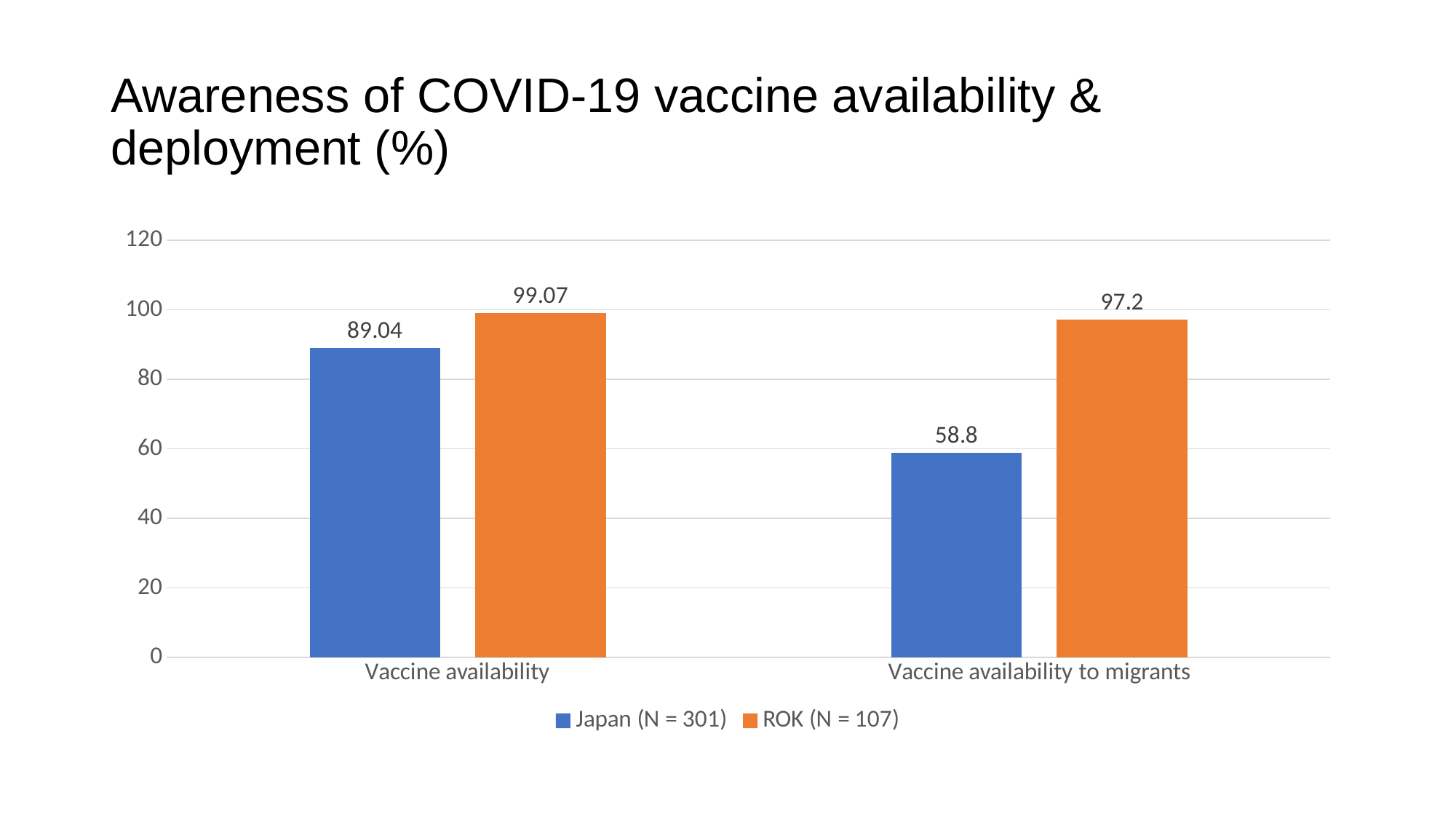
What is the value for Japan (N = 301) for Vaccine availability to migrants? 58.8 What is the difference between the ROK (N = 107) and Japan (N = 301) values for Vaccine availability? 10.03 What is the value for ROK (N = 107) for Vaccine availability? 99.07 What kind of chart is shown on the slide? Bar chart What is the value for ROK (N = 107) for Vaccine availability to migrants? 97.2 Which series has the lowest value for Vaccine availability to migrants? Japan (N = 301) What is the difference between the ROK (N = 107) and Japan (N = 301) values for Vaccine availability to migrants? 38.4 How many categories are shown on the x axis? 2 What is the value for Japan (N = 301) for Vaccine availability? 89.04 Which category has the highest value for the ROK (N = 107) series? Vaccine availability Which is larger: the Japan (N = 301) value for Vaccine availability or the Japan (N = 301) value for Vaccine availability to migrants? Vaccine availability How many series does the legend list? 2